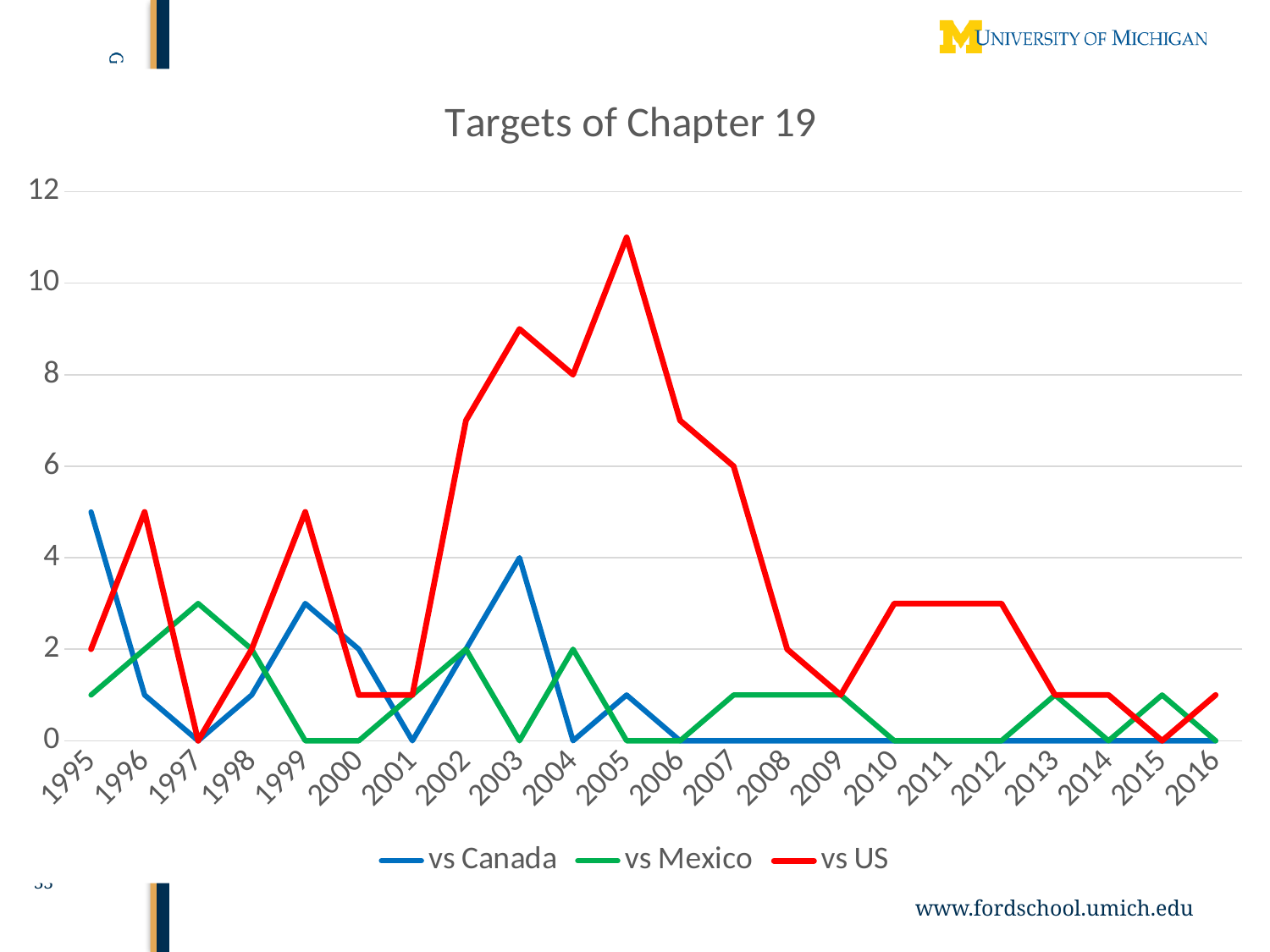
How many series does the legend list? 3 Is the value for vs Canada in 1995 greater or less than 4? greater Which is larger in 2005, the value for vs US or the value for vs Canada? vs US Does the vs US series rise or fall from 2005 to 2008? fall Is the value for vs US in 2005 greater or less than 10? greater What is the value for vs US in 2007? 6 What is the value for vs US in 2004? 8 What kind of chart is shown on the slide? line chart In which year does the vs US series reach its highest value? 2005 What is the difference between the vs US value and the vs Canada value in 2004? 8 How many years are shown along the x axis? 22 What is the value for vs Canada in 2003? 4